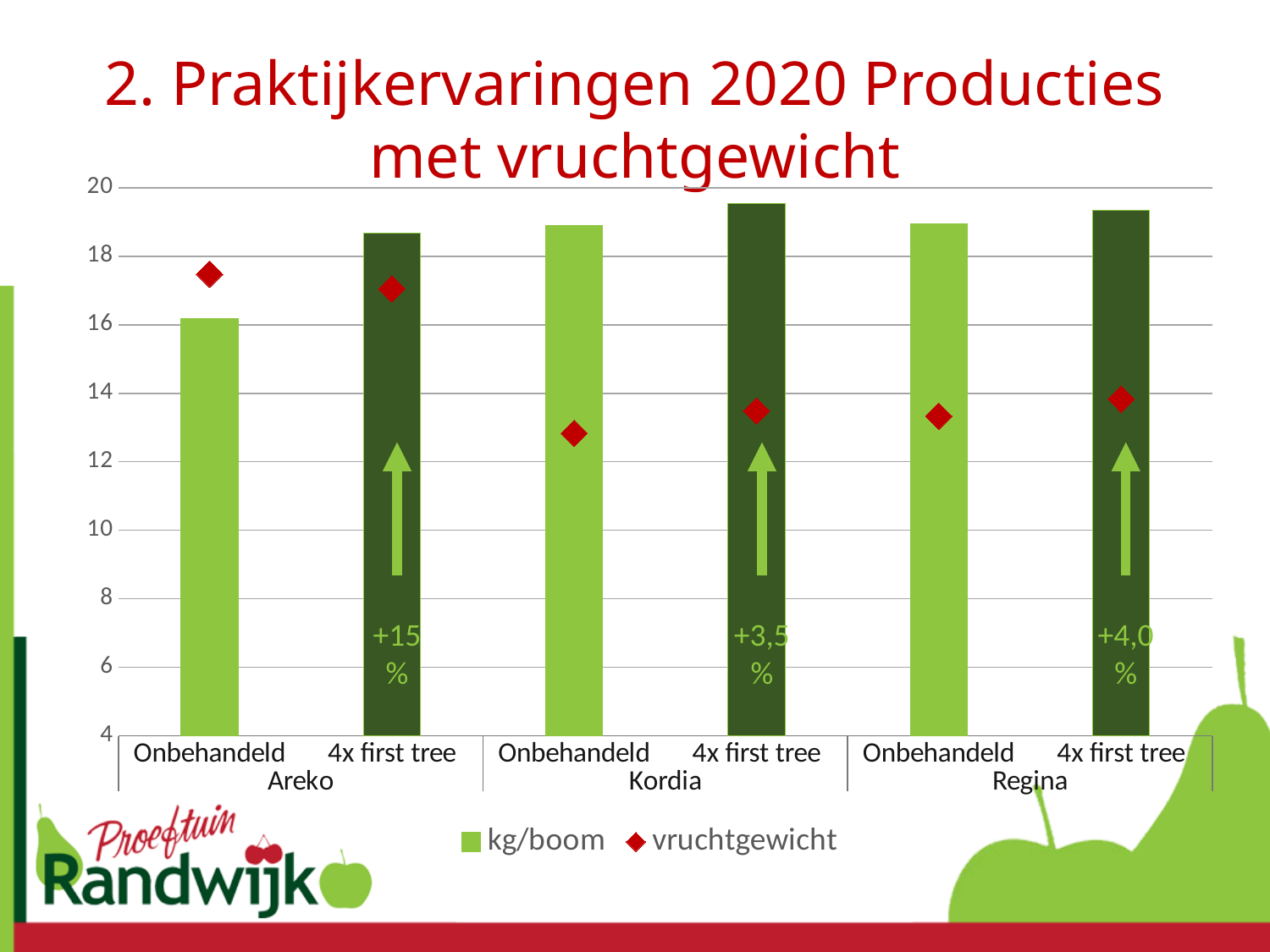
Which has the higher vruchtgewicht value: Onbehandeld Areko or Onbehandeld Regina? Onbehandeld Areko What kind of chart is shown on the slide? combination bar and line chart (bars with diamond markers) Is the vruchtgewicht value for Onbehandeld Kordia greater or less than 14? less How many cultivar groups are shown on the x axis? 3 Which bar has the lowest kg/boom value? Onbehandeld Areko Which has the higher kg/boom value: Onbehandeld Areko or 4x first tree Areko? 4x first tree Areko How many bars are plotted in the chart? 6 Is the kg/boom value for Onbehandeld Areko greater or less than 18? less What percentage increase is printed on the 4x first tree bar for Areko? +15 % Is the kg/boom value for 4x first tree Kordia greater or less than 18? greater What percentage increase is printed on the 4x first tree bar for Kordia? +3,5 % How many series does the legend list? 2